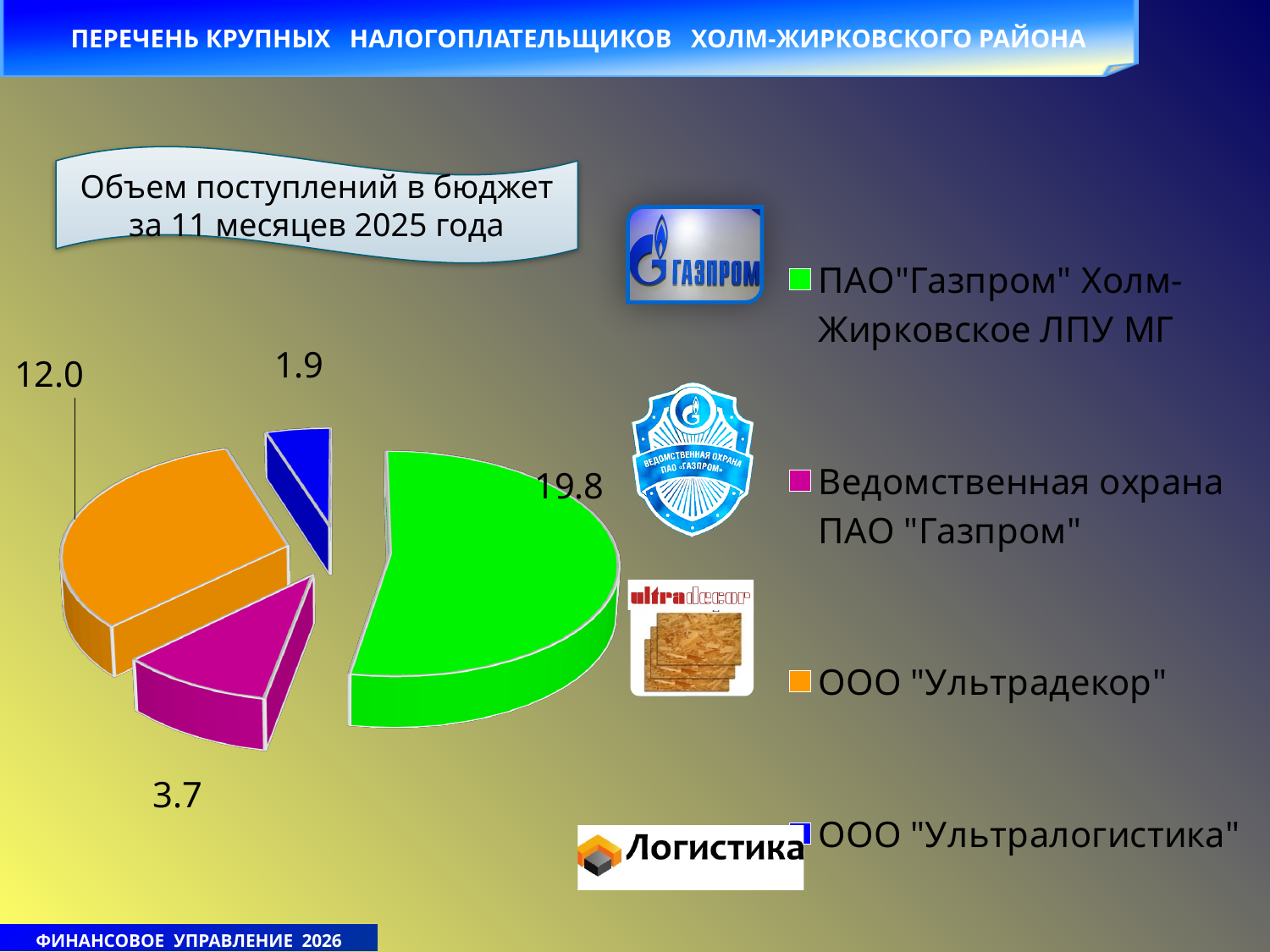
What is the value for ПАО "Газпром" Холм-Жирковское ЛПУ МГ? 19.8 What is the difference between the values for ПАО "Газпром" Холм-Жирковское ЛПУ МГ and ООО "Ультрадекор"? 7.8 What is the value for Ведомственная охрана ПАО "Газпром"? 3.7 What is the value for ООО "Ультралогистика"? 1.9 What colour is the slice for ООО "Ультрадекор"? Orange What period does the chart's caption say the budget receipts cover? 11 месяцев 2025 года Which category has the largest slice of the pie? ПАО "Газпром" Холм-Жирковское ЛПУ МГ Which is larger: the value for ООО "Ультрадекор" or the value for Ведомственная охрана ПАО "Газпром"? ООО "Ультрадекор" What is the value for ООО "Ультрадекор"? 12.0 Which category has the smallest slice of the pie? ООО "Ультралогистика" How many slices does the pie chart have? 4 What kind of chart is shown on the slide? Pie chart